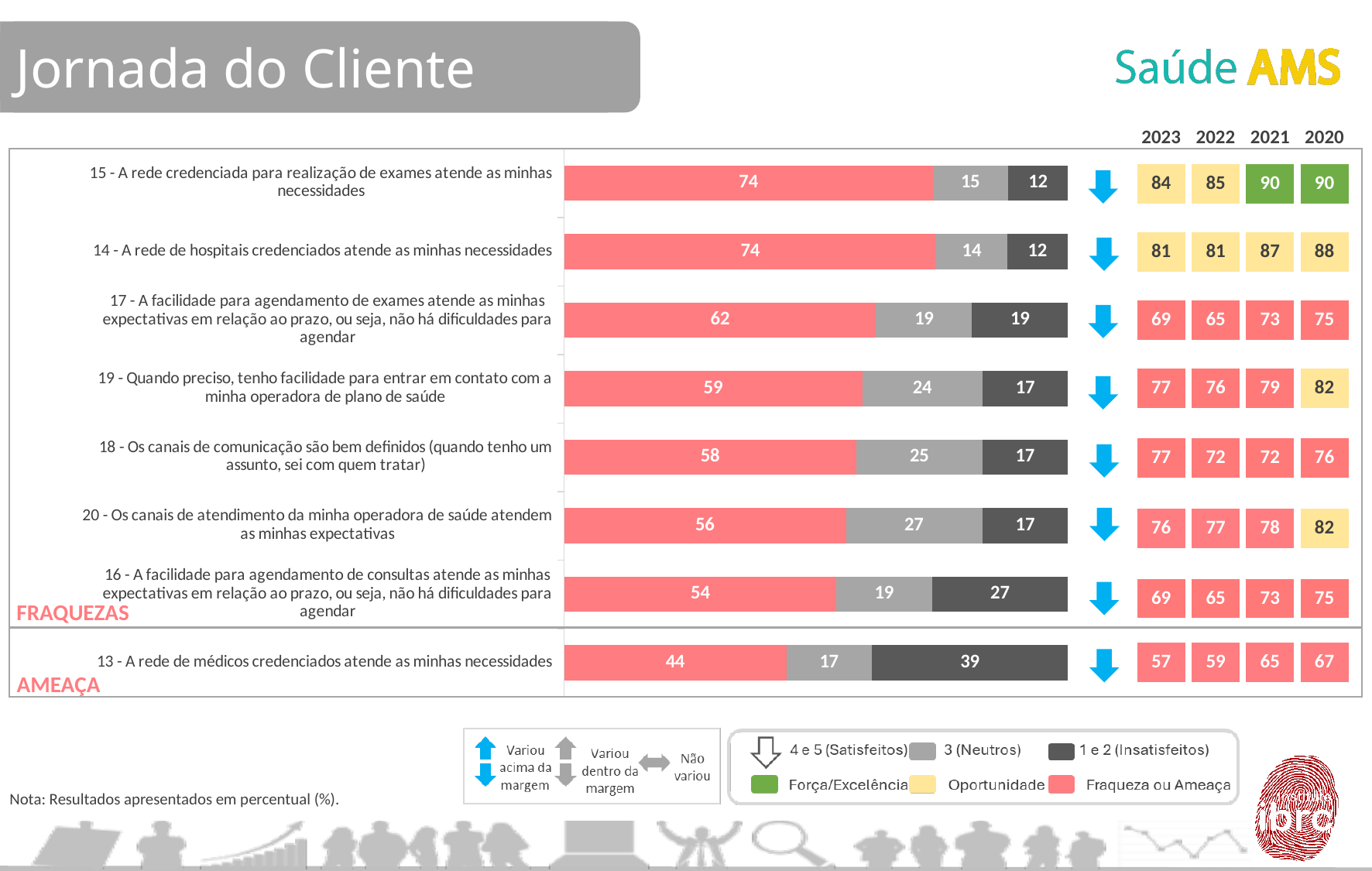
What is the dissatisfied (1 e 2) value for item 16 - A facilidade para agendamento de consultas? 27 What is the total of the three segments of the bar for item 14 - A rede de hospitais credenciados? 100 Which item has the lowest satisfied (4 e 5) value? 13 - A rede de médicos credenciados atende as minhas necessidades What is the satisfied (4 e 5) value for item 13 - A rede de médicos credenciados atende as minhas necessidades? 44 Which has a larger neutral (3) value: item 19 or item 17? Item 19 How many items (bars) are plotted in the chart? 8 Which item has the highest dissatisfied (1 e 2) value? 13 - A rede de médicos credenciados atende as minhas necessidades What is the 2023 value shown for item 15 - A rede credenciada para realização de exames? 84 What is the difference between the satisfied values of item 15 (74) and item 13 (44)? 30 How many rating categories does the legend list for the bar segments? 3 What is the neutral (3) value for item 20 - Os canais de atendimento da minha operadora de saúde atendem as minhas expectativas? 27 What kind of chart is shown on the slide? Stacked bar chart